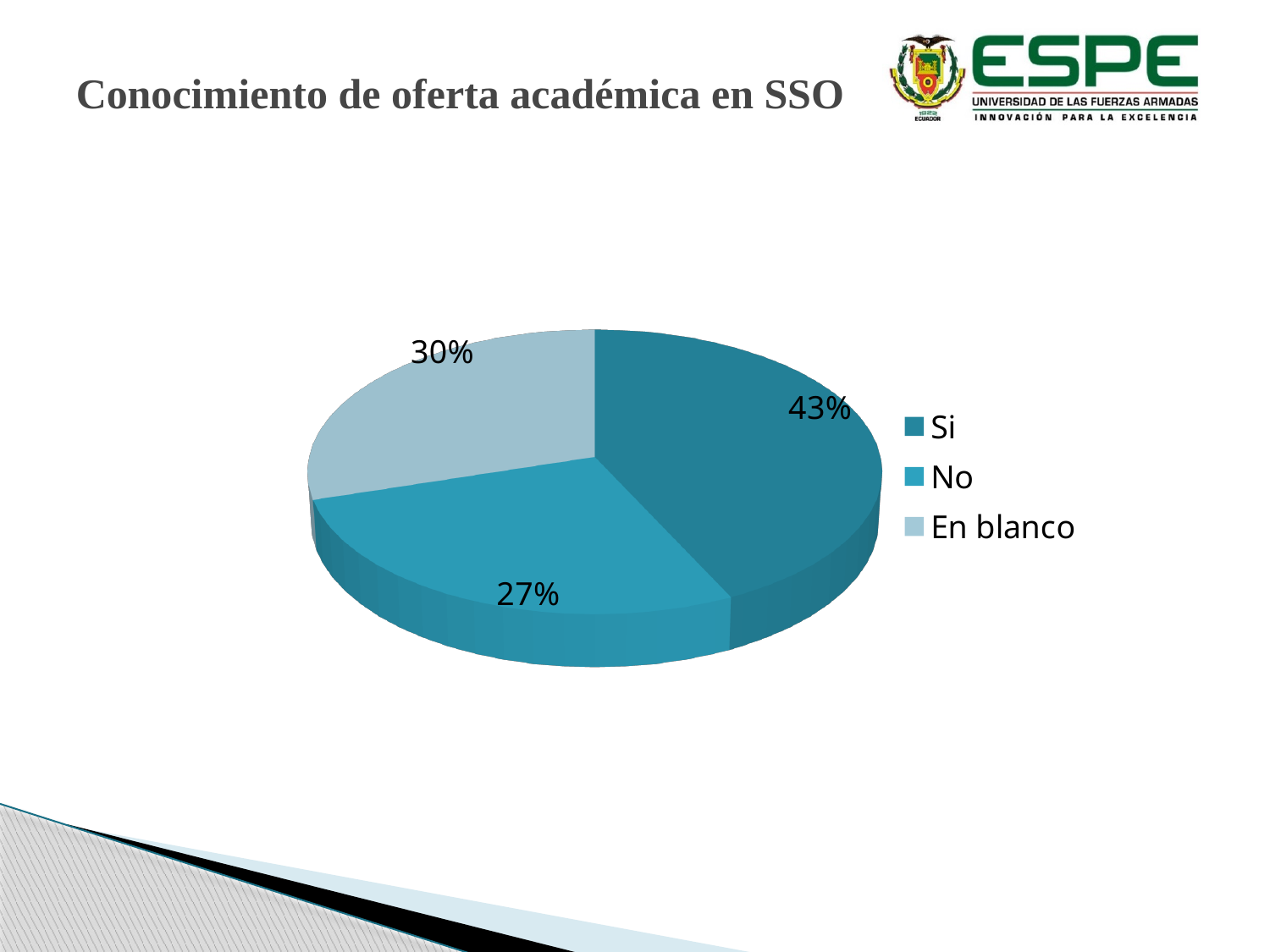
What is the title of the slide containing the pie chart? Conocimiento de oferta académica en SSO Which is larger, the "En blanco" slice or the "No" slice? En blanco How many slices does the pie chart have? 3 What share of the pie does the "No" slice represent? 27% Which category has the largest slice of the pie? Si What is the difference in percentage points between the "En blanco" slice and the "No" slice? 3 How many entries does the legend list? 3 What kind of chart is shown on the slide? pie chart Which category has the smallest slice of the pie? No What is the difference in percentage points between the "Si" slice and the "No" slice? 16 What share of the pie does the "Si" slice represent? 43% What share of the pie does the "En blanco" slice represent? 30%